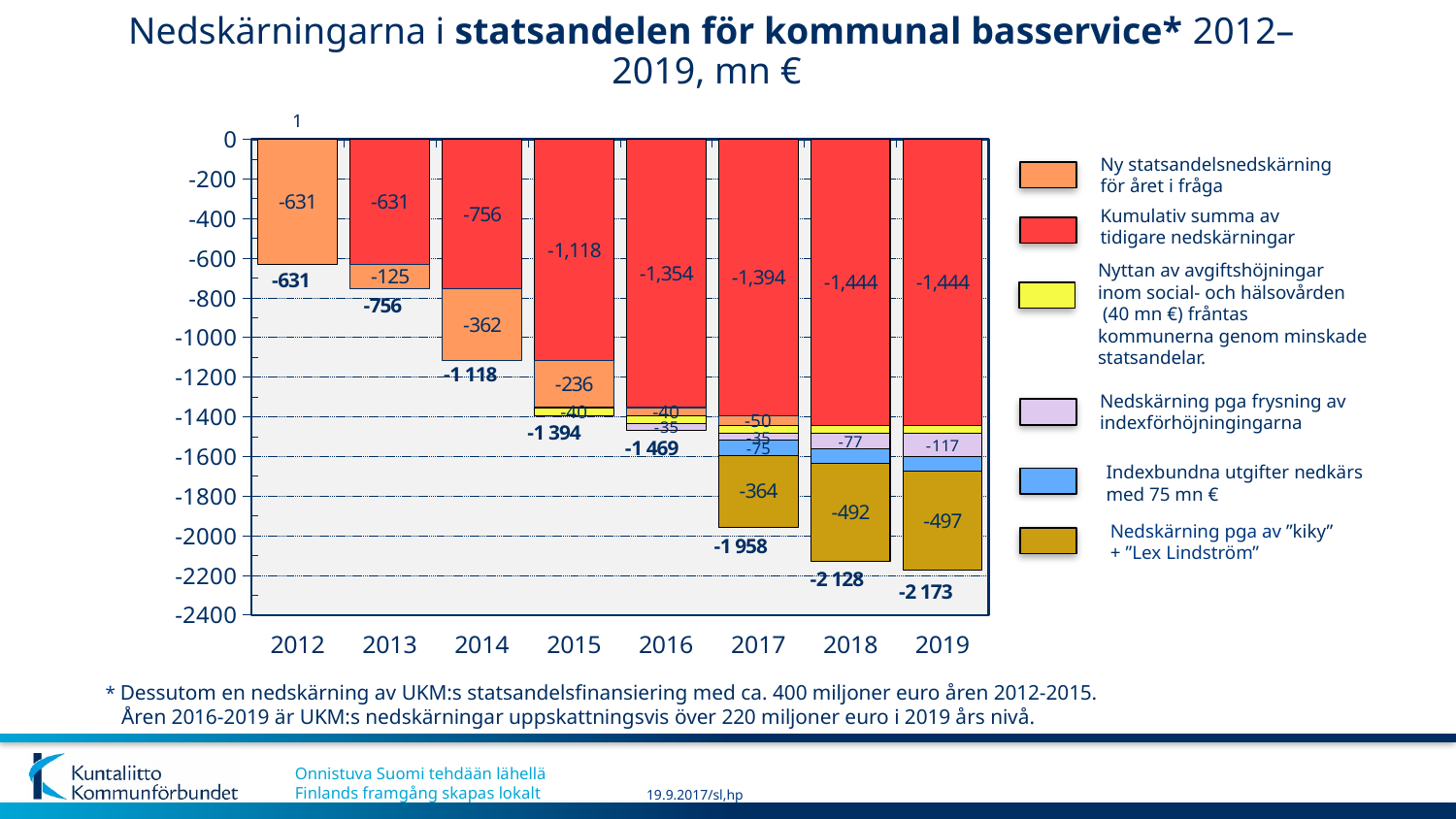
What kind of chart is shown on the slide? Stacked bar chart What is the total cut (bold label) shown for 2017? -1 958 Which year has the largest total cut (most negative bold total)? 2019 What is the value of the 'Nedskärning pga av "kiky" + "Lex Lindström"' (gold) segment for 2018? -492 By how much does the total cut for 2019 (-2 173) exceed the total cut for 2018 (-2 128) in magnitude? 45 How many entries does the chart's legend list? 6 Do the total cuts become larger or smaller in magnitude from 2012 to 2019? Larger What is the value of the 'Kumulativ summa av tidigare nedskärningar' (red) segment for 2016? -1,354 What is the total cut (bold label) shown for 2019? -2 173 How many years (categories) are shown on the x axis of the chart? 8 What is the value of the 'Ny statsandelsnedskärning för året i fråga' (orange) segment for 2014? -362 Which year has the smallest total cut (least negative bold total)? 2012